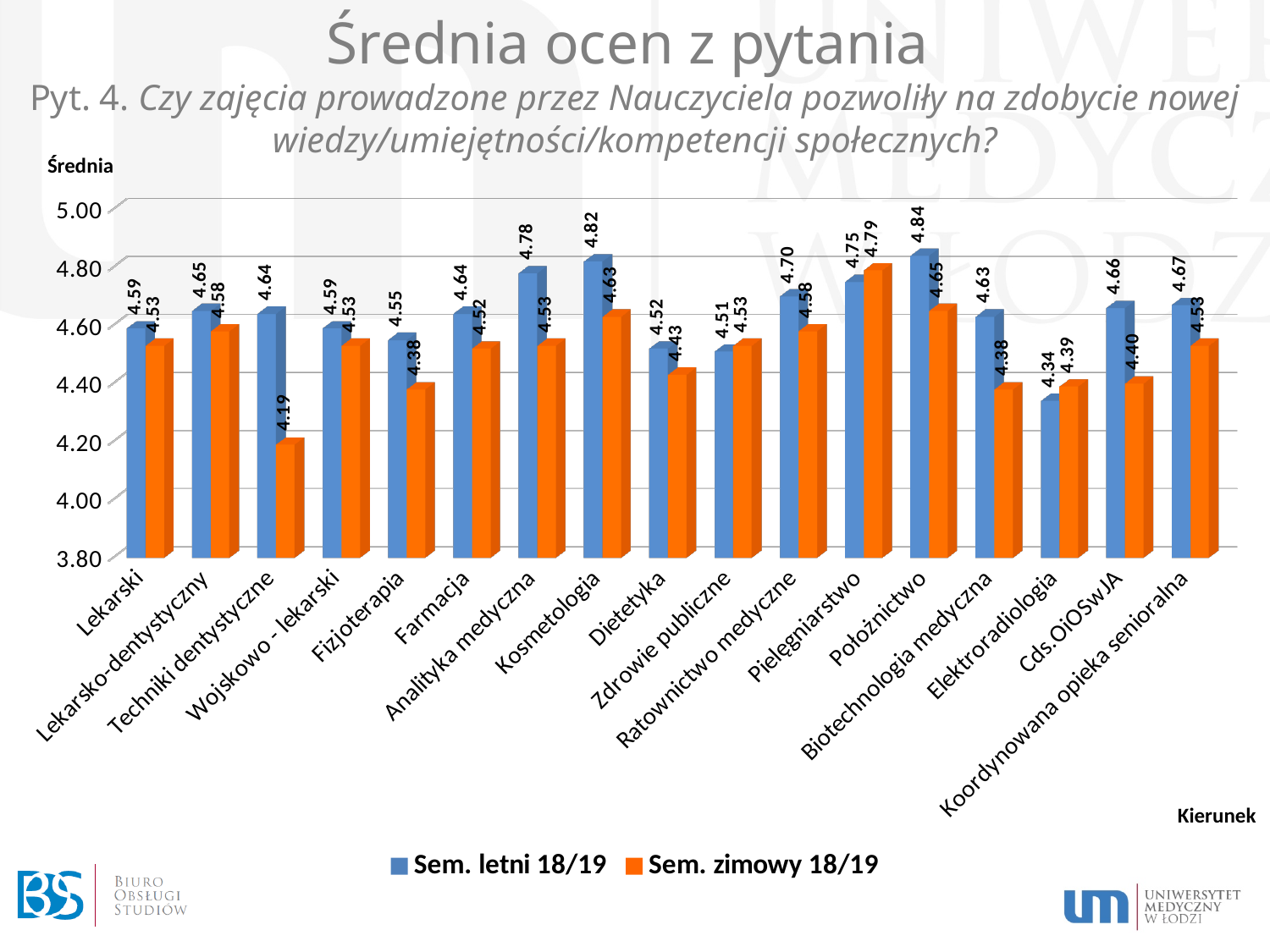
Which colour represents Sem. zimowy 18/19 in the legend? Orange What is the value for Sem. letni 18/19 for Kosmetologia? 4.82 Which is larger for Pielęgniarstwo: the Sem. letni 18/19 value or the Sem. zimowy 18/19 value? Sem. zimowy 18/19 What kind of chart is shown on the slide? Bar chart What is the difference between the Sem. letni 18/19 and Sem. zimowy 18/19 values for Techniki dentystyczne? 0.45 What is the value for Sem. zimowy 18/19 for Pielęgniarstwo? 4.79 How many series does the legend list? 2 How many categories (kierunki) are shown on the x axis? 17 What is the value for Sem. zimowy 18/19 for Techniki dentystyczne? 4.19 Which category has the lowest value for Sem. letni 18/19? Elektroradiologia Which category has the highest value for Sem. letni 18/19? Położnictwo Which category has the lowest value for Sem. zimowy 18/19? Techniki dentystyczne